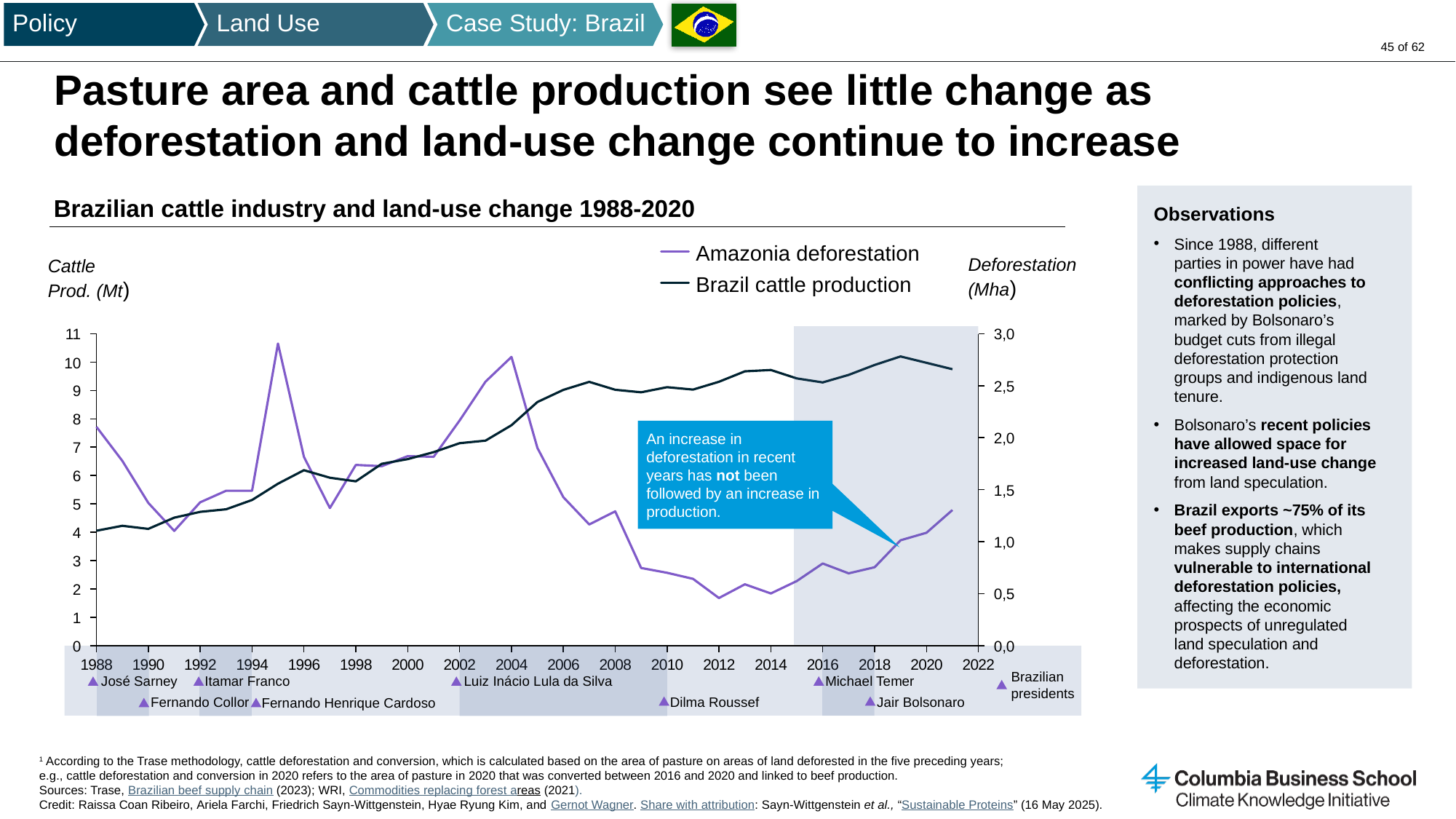
Does Brazil cattle production generally rise or fall from 1988 to 2021? rise Which is larger: Brazil cattle production in 1988 or in 2019? 2019 What colour is the Amazonia deforestation line? purple How many series does the chart legend list? 2 Is the value for Brazil cattle production in 2019 greater or less than 9 Mt? greater Is the value for Brazil cattle production in 1988 greater or less than 5 Mt? less What is the title of the chart? Brazilian cattle industry and land-use change 1988-2020 Is the value for Amazonia deforestation in 2021 greater or less than 2,0 Mha? less In which year does Amazonia deforestation reach its highest value? 1995 What kind of chart is shown on the slide? line chart